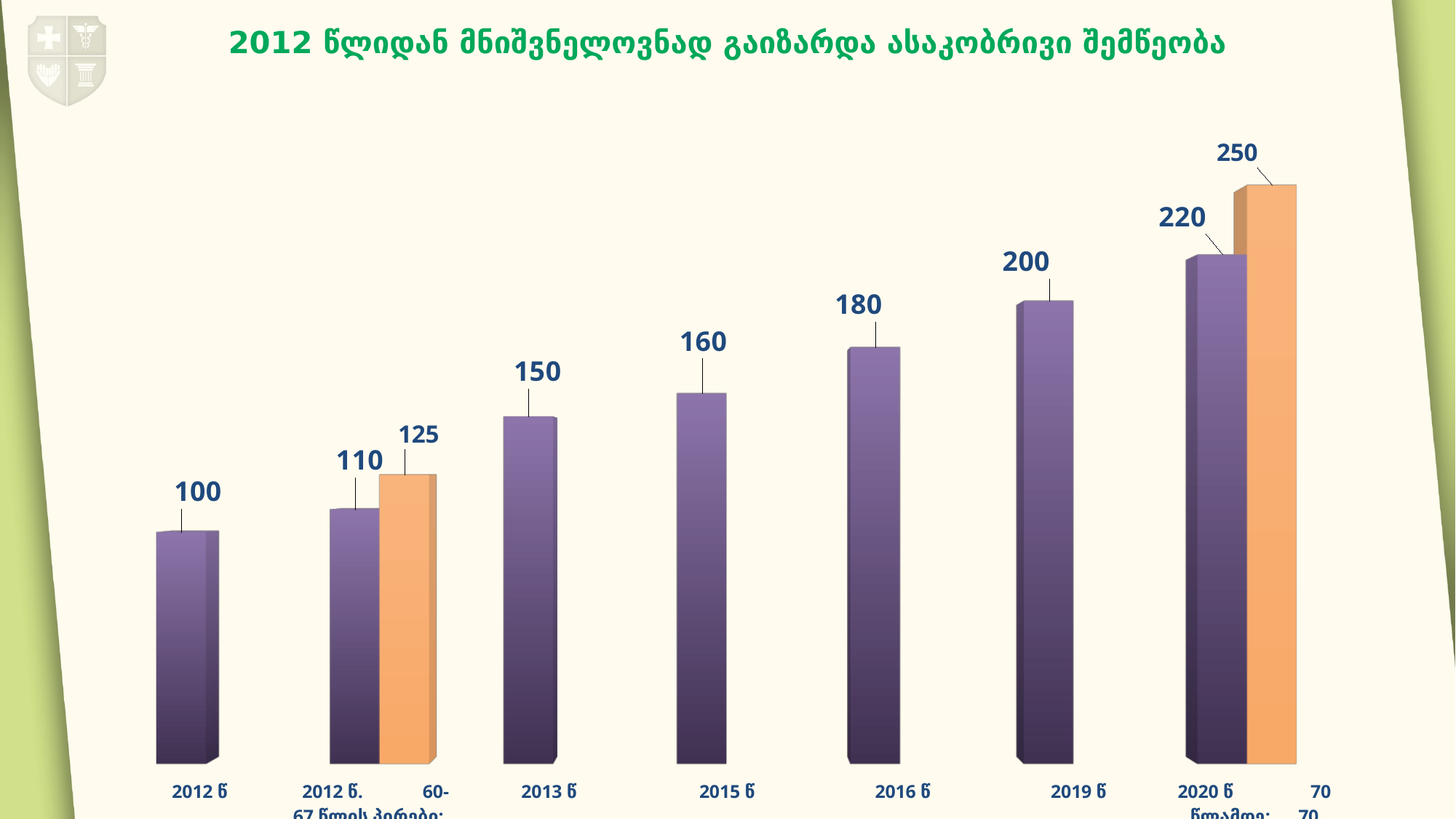
What is the value of the orange bar in the second category (2012 წ. 60-67 წლის პირები)? 125 What is the value of the bar for 2016 წ? 180 What is the value of the purple bar for 2013 წ? 150 Do the purple bar values rise or fall from left to right along the x axis? Rise Which bar on the chart has the highest value? The orange bar for 2020 წ (250) Which is larger, the value for 2016 წ or the value for 2013 წ? 2016 წ What is the difference between the orange and purple bars for 2020 წ? 30 What is the value of the purple bar for 2012 წ? 100 What is the value of the orange bar for 2020 წ? 250 How many categories are shown on the x axis of the chart? 7 Which bar on the chart has the lowest value? 2012 წ (100) What is the difference between the value for 2019 წ and the value for 2015 წ? 40